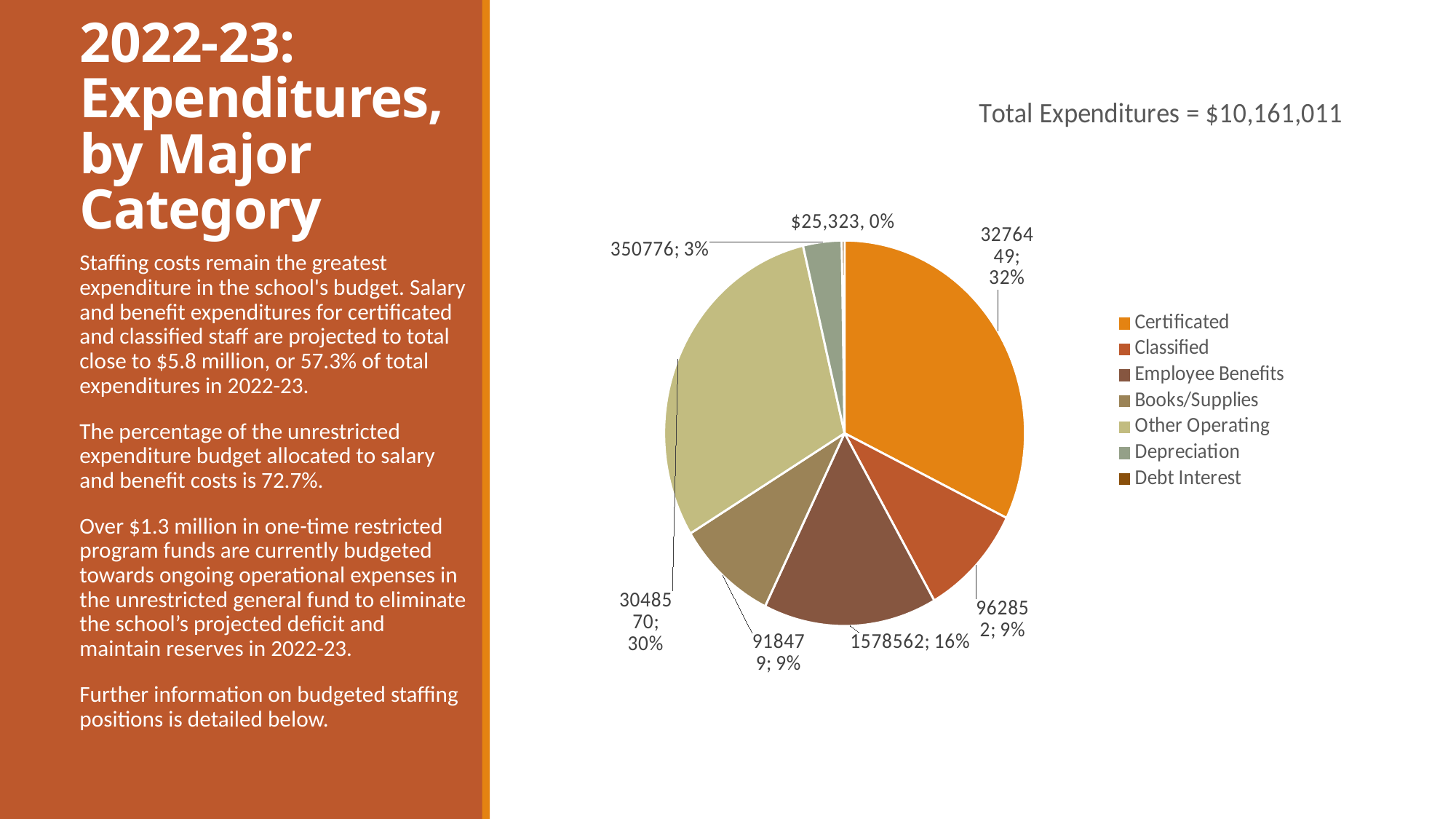
What total expenditures figure is stated above the chart? $10,161,011 What is the value shown for Depreciation? 350776 Which category has the largest share of expenditures? Certificated Which is larger, Employee Benefits or Depreciation? Employee Benefits What percentage share does Certificated have? 32% What is the value shown for Employee Benefits? 1578562 What percentage of total expenditures is Other Operating? 30% What is the difference between the Employee Benefits value and the Classified value? 615710 What type of chart is shown on the slide? pie chart How many categories does the pie chart show? 7 Which category has the smallest share of expenditures? Debt Interest What is the value shown for Debt Interest? $25,323